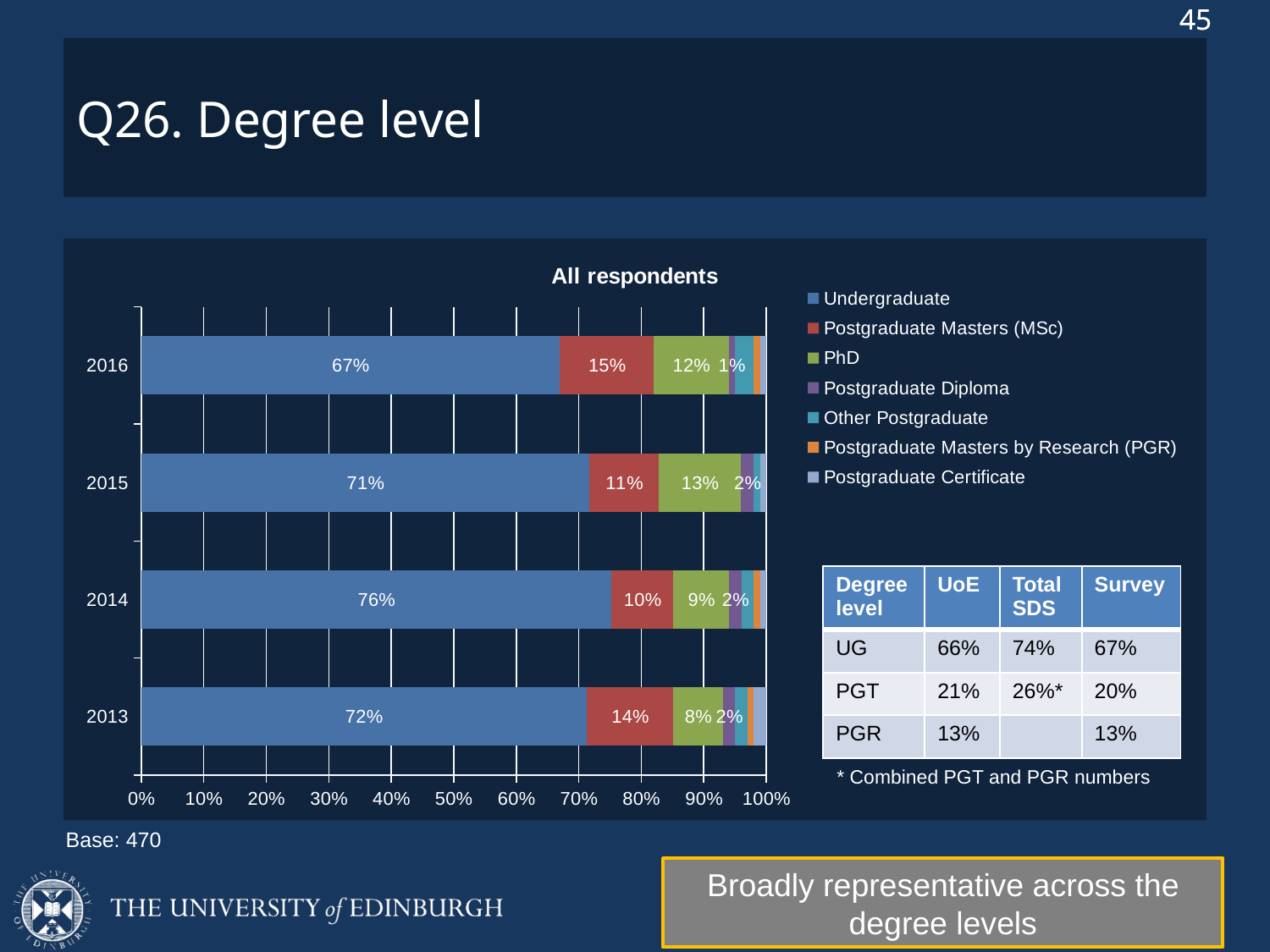
Which year has the lowest Undergraduate share? 2016 What is the PhD share for 2015? 13% What is the title of the chart? All respondents What is the Postgraduate Masters (MSc) share for 2013? 14% What is the Undergraduate share for 2016? 67% What is the difference between the Undergraduate share in 2014 and in 2016? 9 percentage points Which year has the larger PhD share, 2016 or 2013? 2016 Which year has the highest Undergraduate share? 2014 How many series does the chart legend list? 7 How many years are shown on the chart's vertical axis? 4 What kind of chart is shown on the slide? Stacked bar chart What is the Postgraduate Masters (MSc) share for 2014? 10%